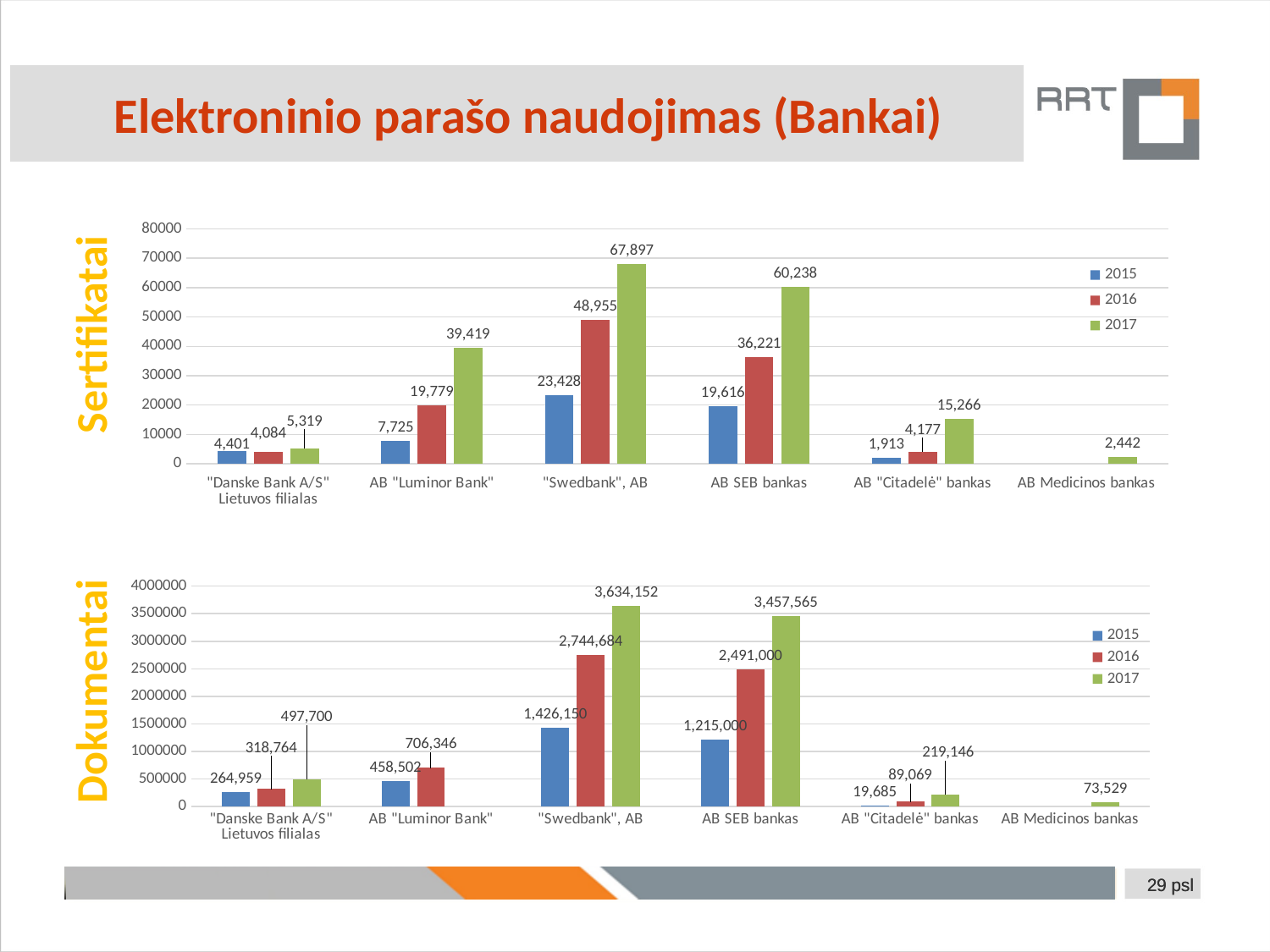
How many bank categories are shown on the x axis of the Dokumentai chart? 6 In the Dokumentai chart, which bank has the lowest 2017 value? AB Medicinos bankas In the Sertifikatai chart, which bank has the highest 2017 value? "Swedbank", AB In the Sertifikatai chart, what is the difference between the 2017 and 2016 values for AB SEB bankas? 24,017 In the Dokumentai chart, how do the values for AB "Citadelė" bankas change from 2015 to 2017? They rise In the Sertifikatai chart, what is the 2016 value for AB "Luminor Bank"? 19,779 In the Sertifikatai chart, what is the 2017 value for "Swedbank", AB? 67,897 In the Sertifikatai chart, how many series does the legend list? 3 In the Dokumentai chart, what is the 2015 value for "Danske Bank A/S" Lietuvos filialas? 264,959 What type of chart is the Sertifikatai chart? Bar chart In the Dokumentai chart, what is the 2017 value for AB SEB bankas? 3,457,565 In the Dokumentai chart, is the 2016 value for "Swedbank", AB larger or smaller than the 2016 value for AB SEB bankas? larger